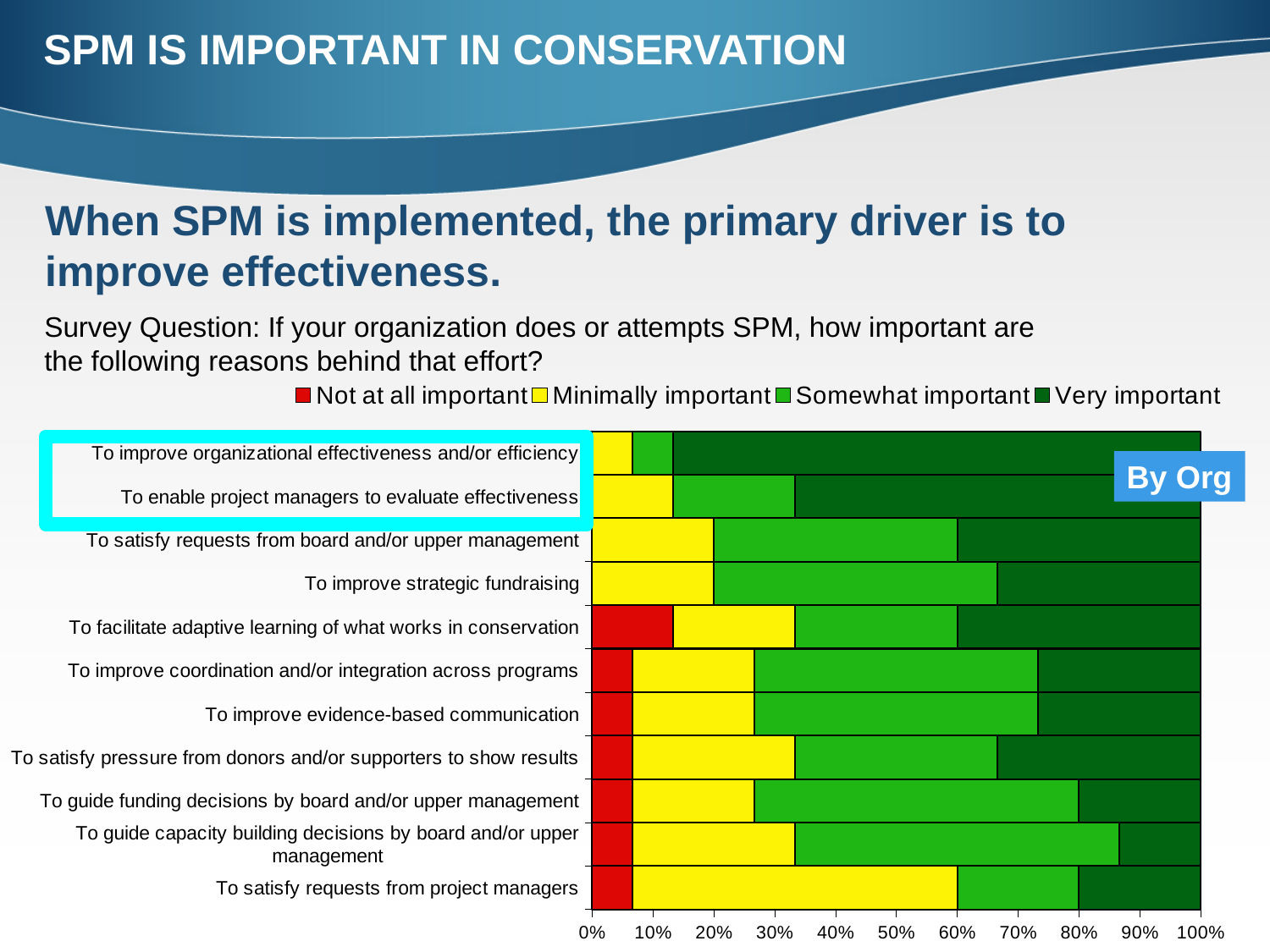
Which category has the largest 'Very important' segment? To improve organizational effectiveness and/or efficiency How many series does the chart legend list? 4 Is the 'Not at all important' share for 'To facilitate adaptive learning of what works in conservation' greater or less than 20%? less Which category has the largest 'Not at all important' segment? To facilitate adaptive learning of what works in conservation What do the segments of each stacked bar add up to? 100% Which category has the largest 'Minimally important' segment? To satisfy requests from project managers What kind of chart is shown on the slide? Stacked bar chart Which colour represents 'Very important' in the legend? Dark green Which has the larger 'Very important' segment: 'To improve organizational effectiveness and/or efficiency' or 'To satisfy requests from project managers'? To improve organizational effectiveness and/or efficiency Is the 'Minimally important' share for 'To satisfy requests from project managers' greater or less than 40%? greater Is the 'Very important' share for 'To improve organizational effectiveness and/or efficiency' greater or less than 80%? greater How many reasons (categories) are plotted on the chart? 11